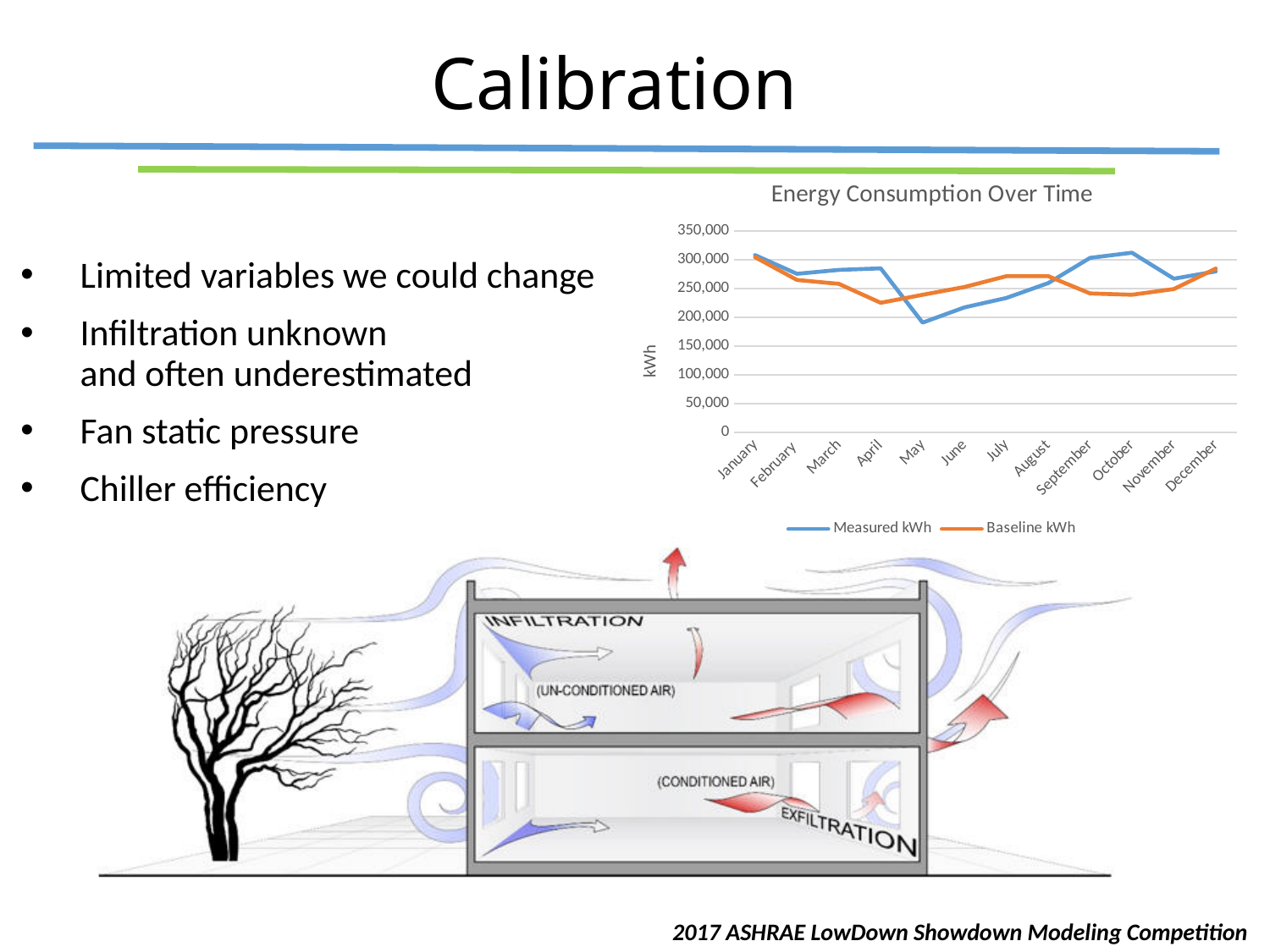
How many months are plotted along the x axis of the "Energy Consumption Over Time" chart? 12 In the "Energy Consumption Over Time" chart, which month has the lowest Baseline kWh value? April In the "Energy Consumption Over Time" chart, which month has the highest Baseline kWh value? January In the "Energy Consumption Over Time" chart, is the Baseline kWh value for April greater or less than 250,000? less How many series does the legend of the "Energy Consumption Over Time" chart list? 2 In the "Energy Consumption Over Time" chart, which series has the higher value in July, Measured kWh or Baseline kWh? Baseline kWh What kind of chart is "Energy Consumption Over Time"? line chart In the "Energy Consumption Over Time" chart, is the Measured kWh value for October greater or less than 300,000? greater In the "Energy Consumption Over Time" chart, which month has the lowest Measured kWh value? May In the "Energy Consumption Over Time" chart, does the Measured kWh line rise or fall from January to May? fall In the "Energy Consumption Over Time" chart, is the Measured kWh value for May greater or less than 200,000? less In the "Energy Consumption Over Time" chart, which series has the higher value in September, Measured kWh or Baseline kWh? Measured kWh